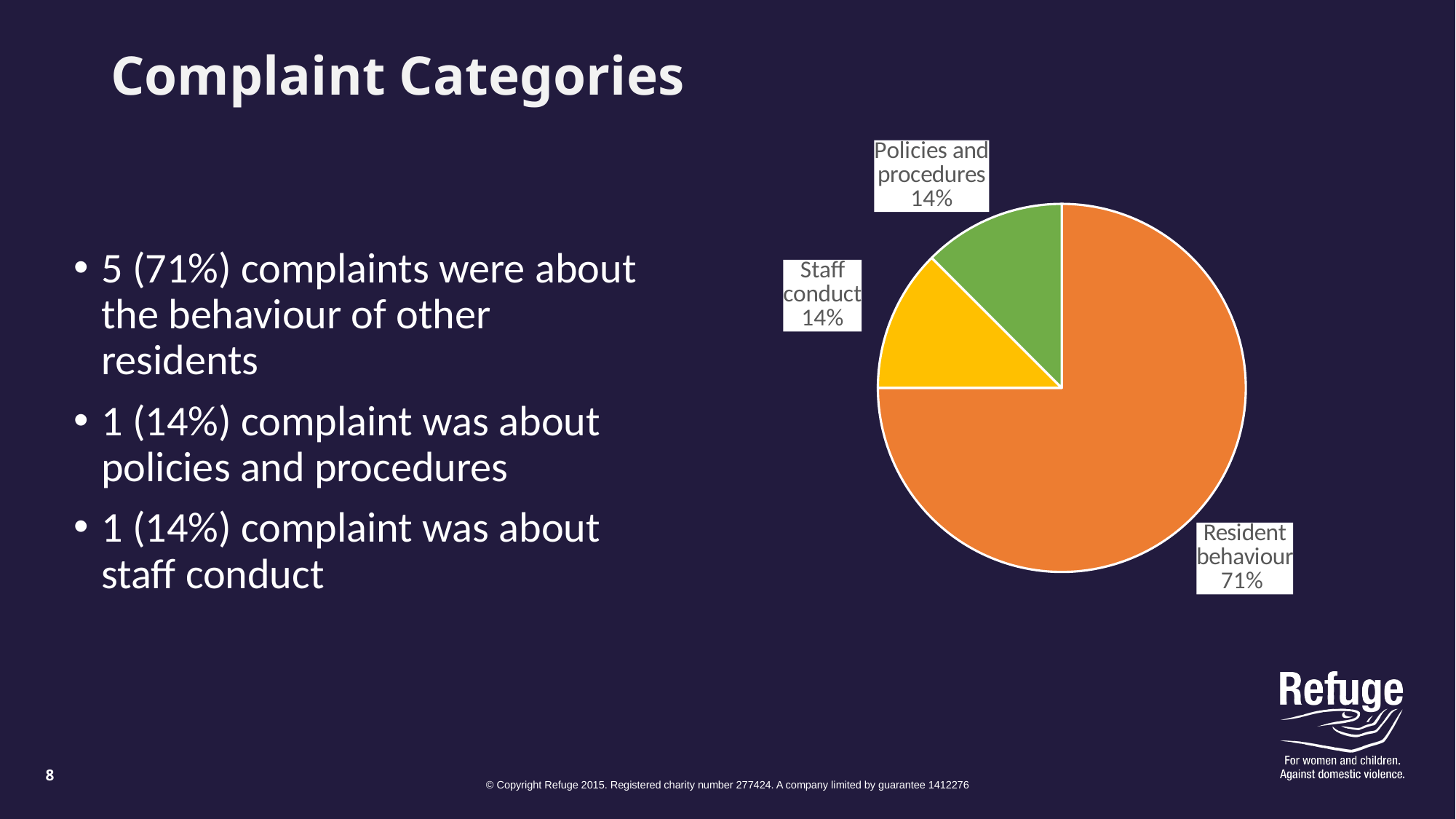
What share of the pie does Resident behaviour take? 71% What share of the pie does Staff conduct take? 14% Which is larger, the Resident behaviour slice or the Policies and procedures slice? Resident behaviour How many categories are shown in the pie chart? 3 What is the difference in percentage points between Resident behaviour and Staff conduct? 57 What is the title of the slide containing the pie chart? Complaint Categories What kind of chart is shown on the slide? pie chart Which category has the largest slice of the pie? Resident behaviour What colour is the Resident behaviour slice? orange What share of the pie does Policies and procedures take? 14% Is the share for Resident behaviour greater or less than 50%? greater